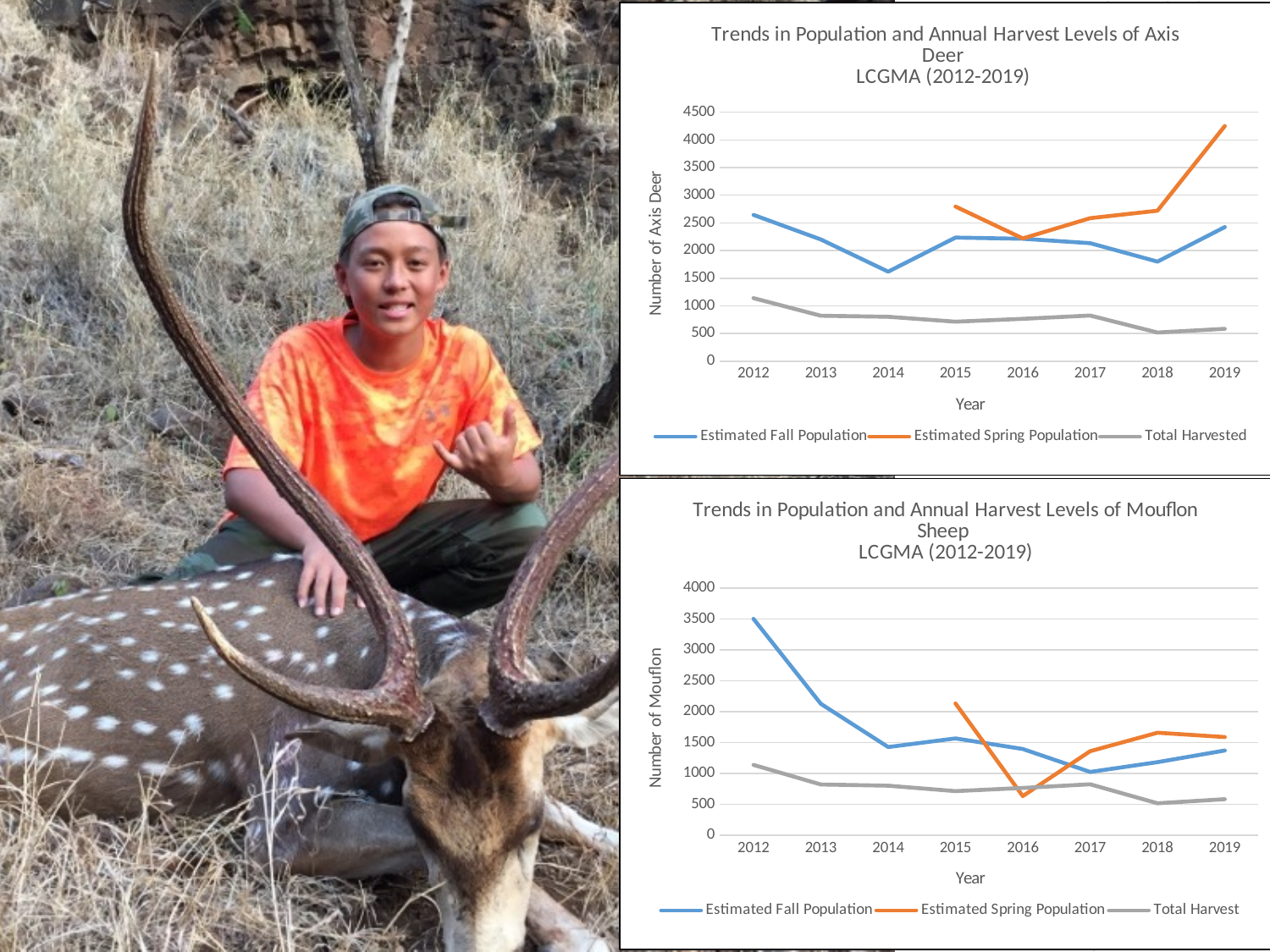
In the Mouflon Sheep chart, is the Estimated Fall Population for 2012 greater or less than 3000? greater In the Axis Deer chart, which year has the lowest Estimated Fall Population? 2014 What kind of chart is the 'Trends in Population and Annual Harvest Levels of Axis Deer' chart? line chart In the Axis Deer chart, is the Estimated Spring Population for 2019 greater or less than 4000? greater In the Mouflon Sheep chart, does the Estimated Fall Population rise or fall from 2012 to 2014? fall In the Mouflon Sheep chart, which is larger in 2015: the Estimated Spring Population or the Estimated Fall Population? Estimated Spring Population What is the y-axis title of the Mouflon Sheep chart? Number of Mouflon In the Axis Deer chart, is the Total Harvested value for 2012 greater or less than 1000? greater In the Axis Deer chart, which year has the highest Estimated Fall Population? 2012 How many years are shown on the x axis of the Mouflon Sheep chart? 8 How many series does the legend of the Axis Deer chart list? 3 In the Mouflon Sheep chart, which year has the lowest Estimated Spring Population? 2016